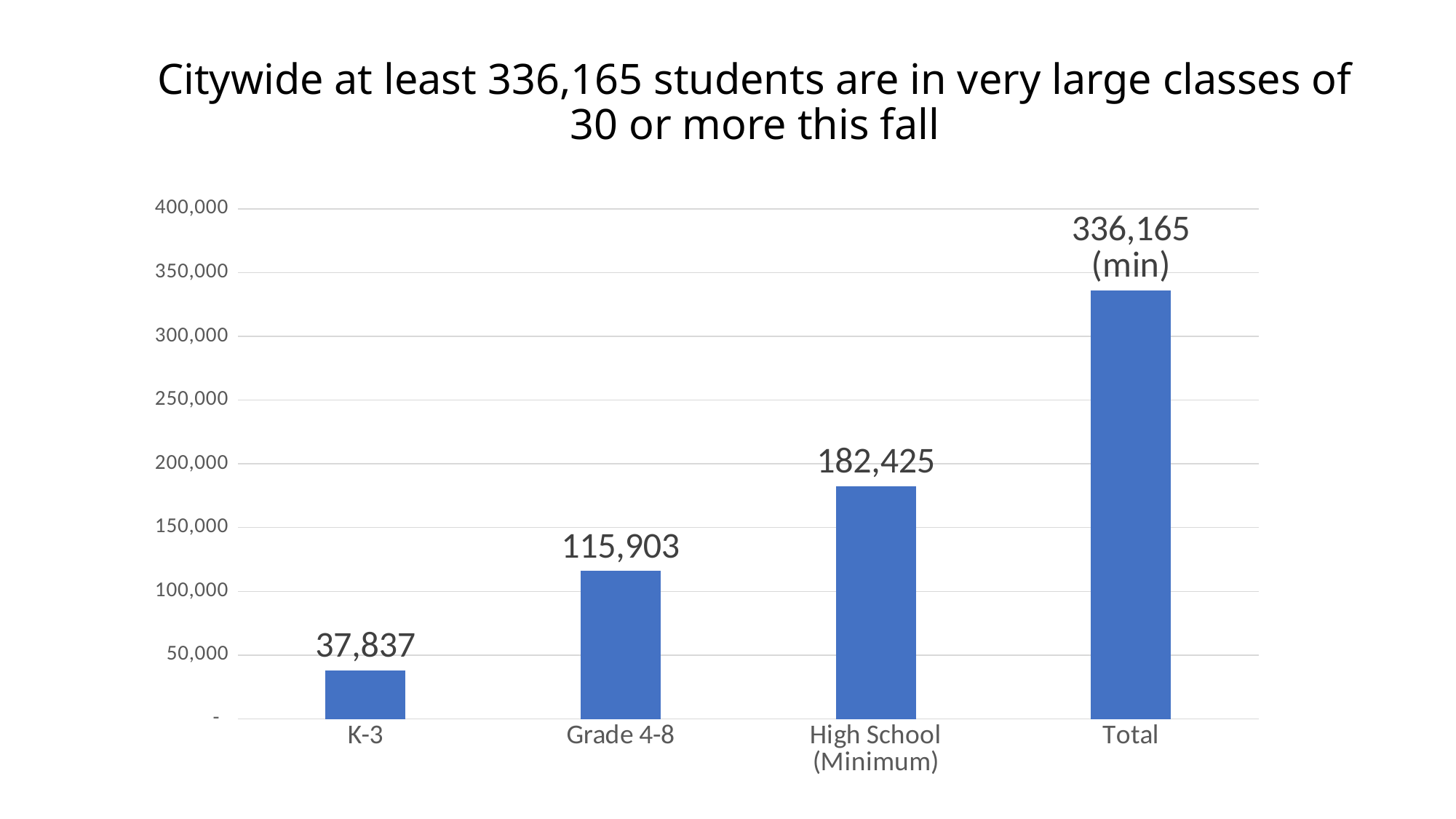
What is the value for Grade 4-8? 115,903 Which category has the highest value? Total Which category has the lowest value? K-3 What is the difference between the values for High School (Minimum) and Grade 4-8? 66,522 What is the value for K-3? 37,837 What kind of chart is shown on the slide? bar chart Which is larger, the value for Grade 4-8 or the value for High School (Minimum)? High School (Minimum) What is the value for High School (Minimum)? 182,425 What is the value for Total? 336,165 What is the title of the chart? Citywide at least 336,165 students are in very large classes of 30 or more this fall What is the difference between the values for Grade 4-8 and K-3? 78,066 How many categories are shown on the x axis? 4